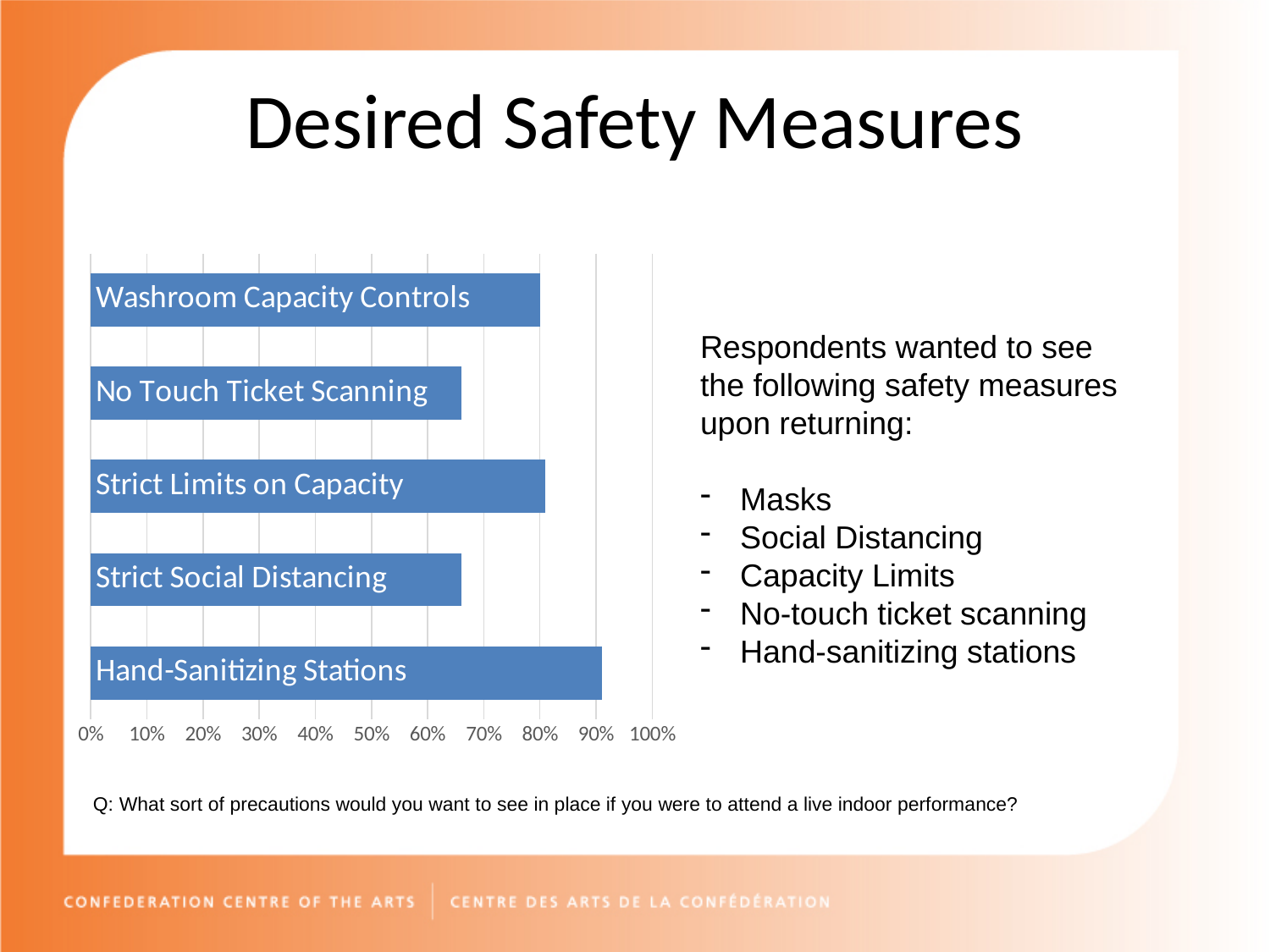
Is the value for No Touch Ticket Scanning greater or less than 70%? less Which is larger, the value for Hand-Sanitizing Stations or the value for No Touch Ticket Scanning? Hand-Sanitizing Stations What is the title of the slide containing the chart? Desired Safety Measures How many safety measures (categories) are plotted in the chart? 5 Is the value for Washroom Capacity Controls greater or less than 70%? greater Which safety measure has the highest value in the chart? Hand-Sanitizing Stations Which is larger, the value for Washroom Capacity Controls or the value for No Touch Ticket Scanning? Washroom Capacity Controls What kind of chart is shown on the slide? bar chart Which is larger, the value for Strict Limits on Capacity or the value for Strict Social Distancing? Strict Limits on Capacity Is the value for Strict Social Distancing greater or less than 60%? greater What is the highest value shown on the chart's horizontal axis? 100%